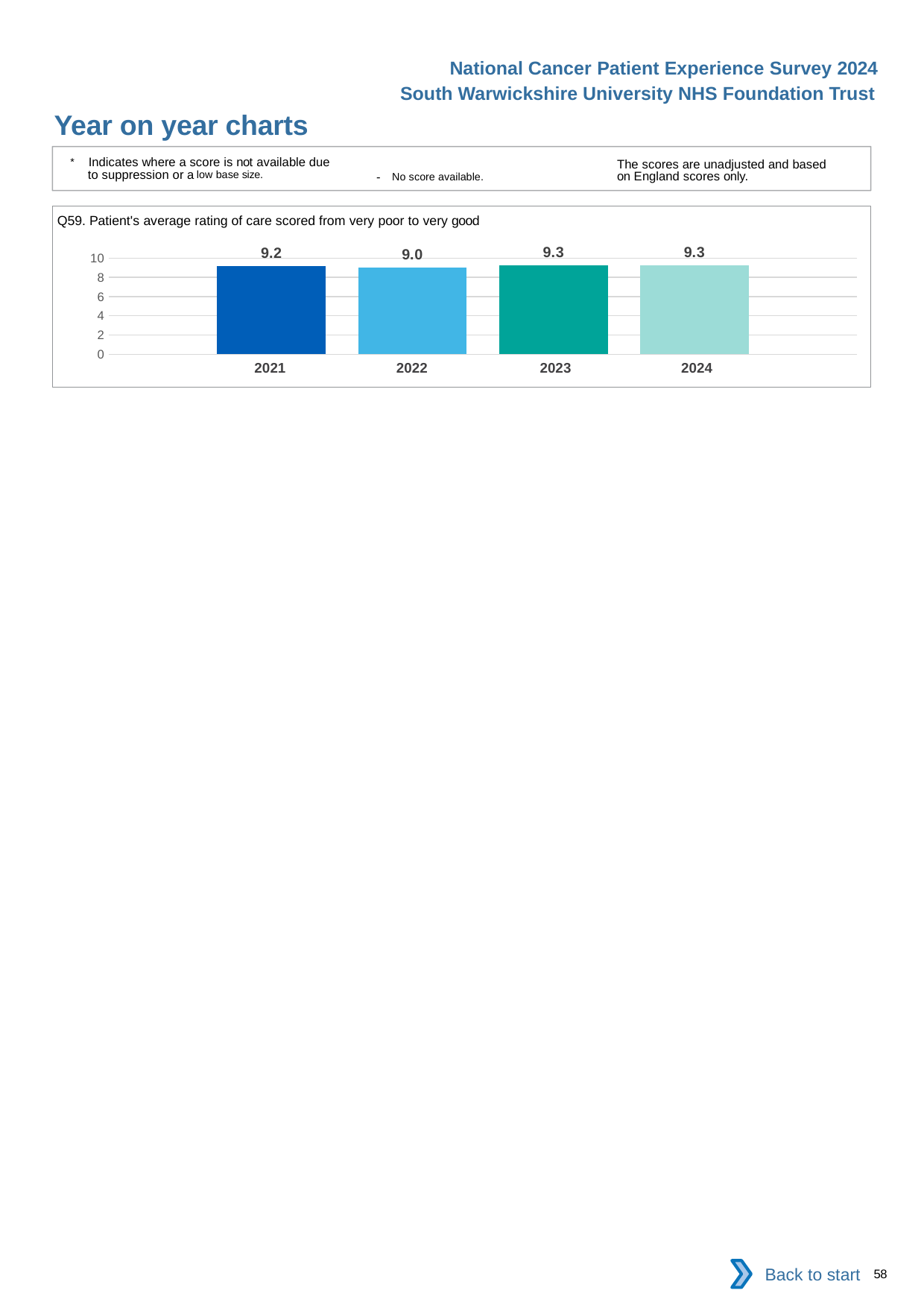
What is the difference between the values for 2021 and 2022? 0.2 Which is larger, the value for 2021 or the value for 2022? 2021 What is the value for 2024? 9.3 What is the title of the chart? Q59. Patient's average rating of care scored from very poor to very good Which year has the lowest value? 2022 What is the difference between the values for 2023 and 2022? 0.3 What is the value for 2023? 9.3 What kind of chart is shown? bar chart What is the value for 2021? 9.2 How many years are shown on the chart? 4 What is the value for 2022? 9.0 Is the value for 2022 greater or less than 8? greater